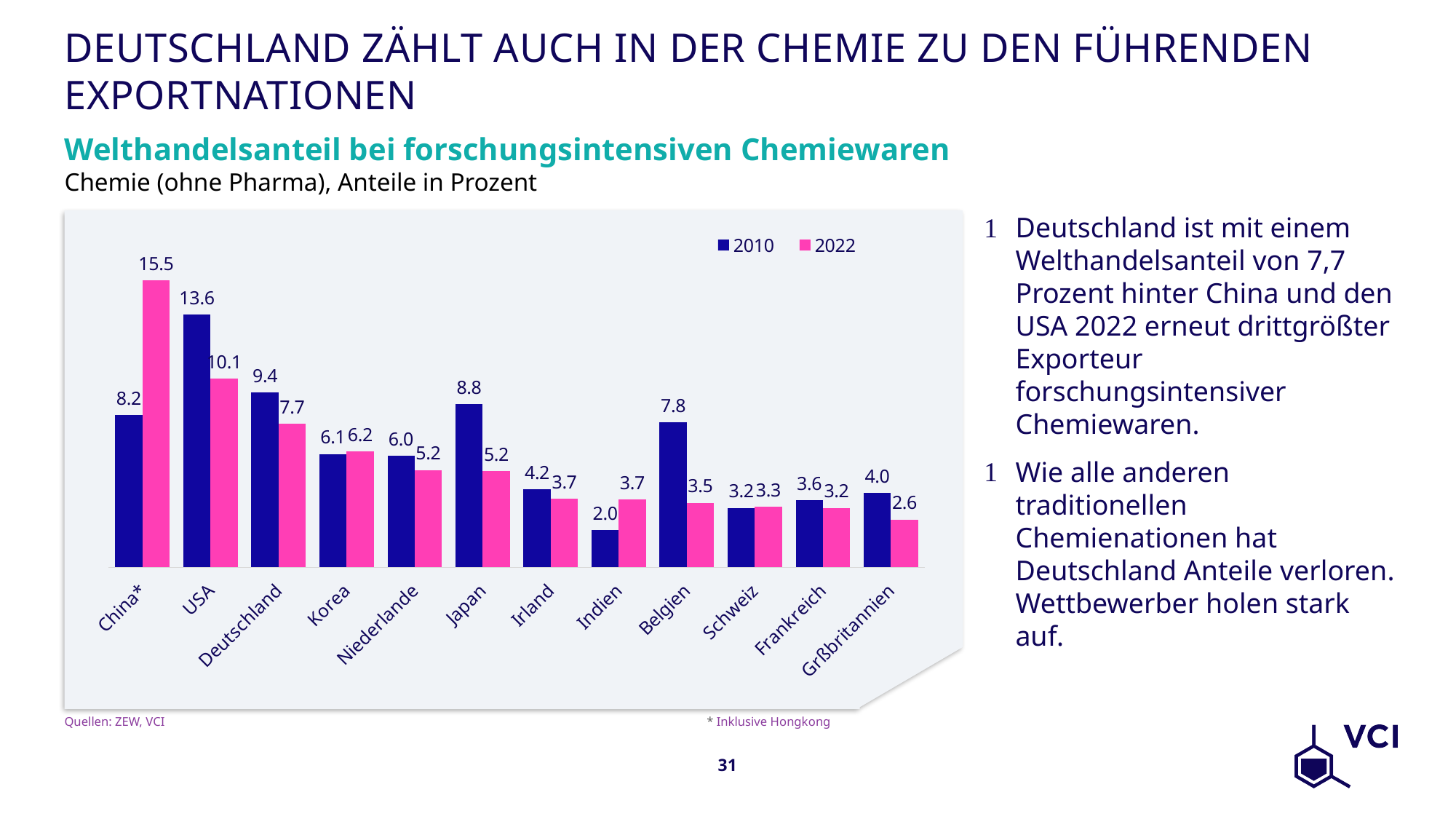
Which colour represents the 2022 series in the legend? Pink Which is larger for USA: the 2010 value or the 2022 value? 2010 What is the 2010 value for USA? 13.6 Which country has the highest 2022 value? China* Which country has the lowest 2010 value? Indien How many series does the legend list? 2 What kind of chart is shown on the slide? Bar chart What is the 2010 value for Belgien? 7.8 What is the 2022 value for Indien? 3.7 What is the difference between the 2010 and 2022 values for Japan? 3.6 What is the 2022 value for Deutschland? 7.7 How many countries are shown on the x axis? 12